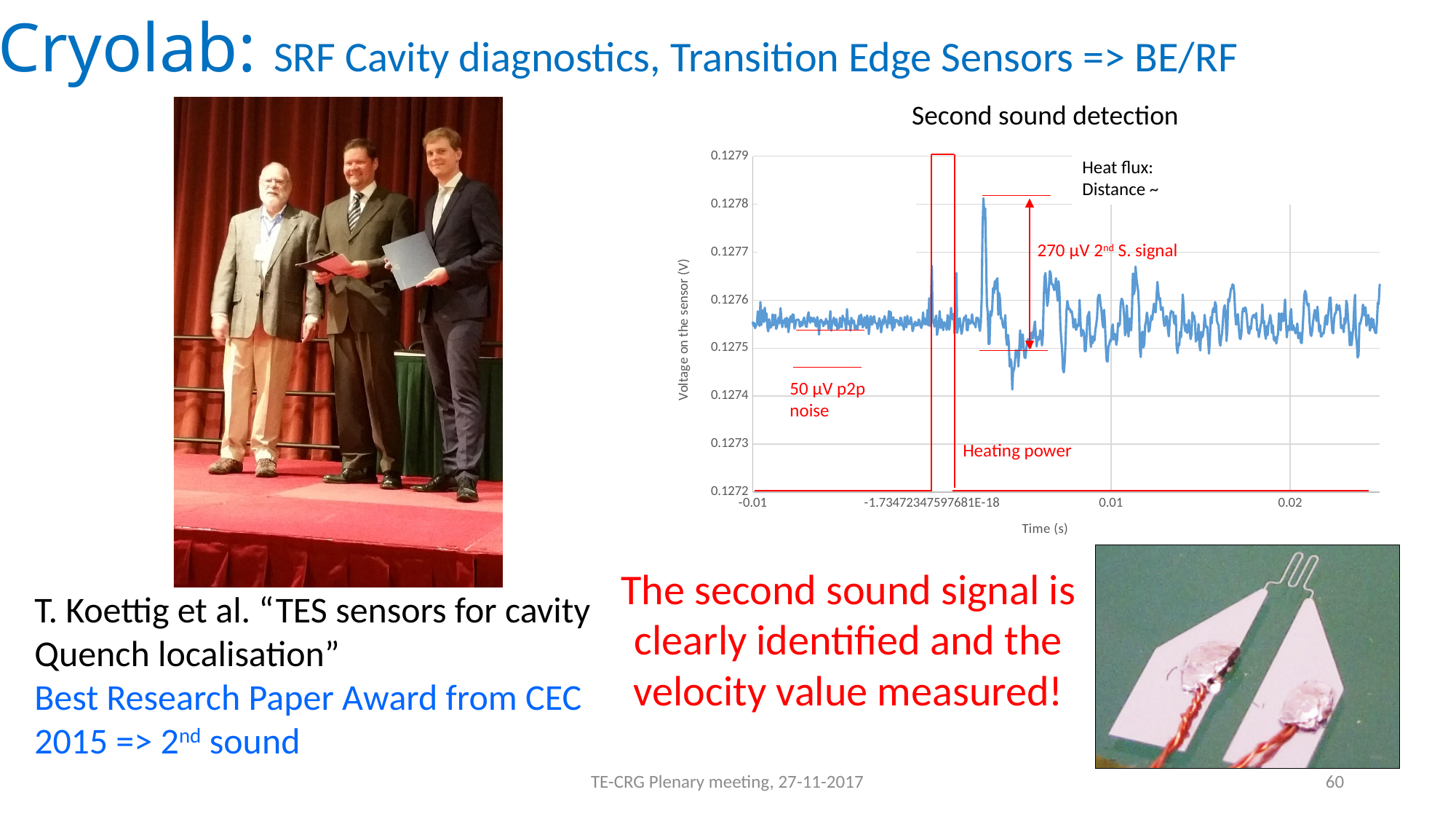
In the "Second sound detection" chart, what peak-to-peak noise level is annotated on the signal? 50 µV p2p noise What is the highest tick value shown on the y axis of the "Second sound detection" chart? 0.1279 What is the lowest tick value shown on the y axis of the "Second sound detection" chart? 0.1272 In the "Second sound detection" chart, is the highest peak of the blue signal greater or less than 0.1277 V? greater What kind of chart is shown under the title "Second sound detection"? line chart What is the title of the chart on the slide? Second sound detection What is the label of the y axis of the "Second sound detection" chart? Voltage on the sensor (V) In the "Second sound detection" chart, what does the red rectangular pulse represent according to its label? Heating power In the "Second sound detection" chart, is the lowest dip of the blue signal after the heating pulse greater or less than 0.1275 V? less What is the unit of the x axis of the "Second sound detection" chart? s In the "Second sound detection" chart, is the baseline voltage before the heating pulse greater or less than 0.1274 V? greater In the "Second sound detection" chart, what amplitude is annotated for the second sound signal? 270 µV